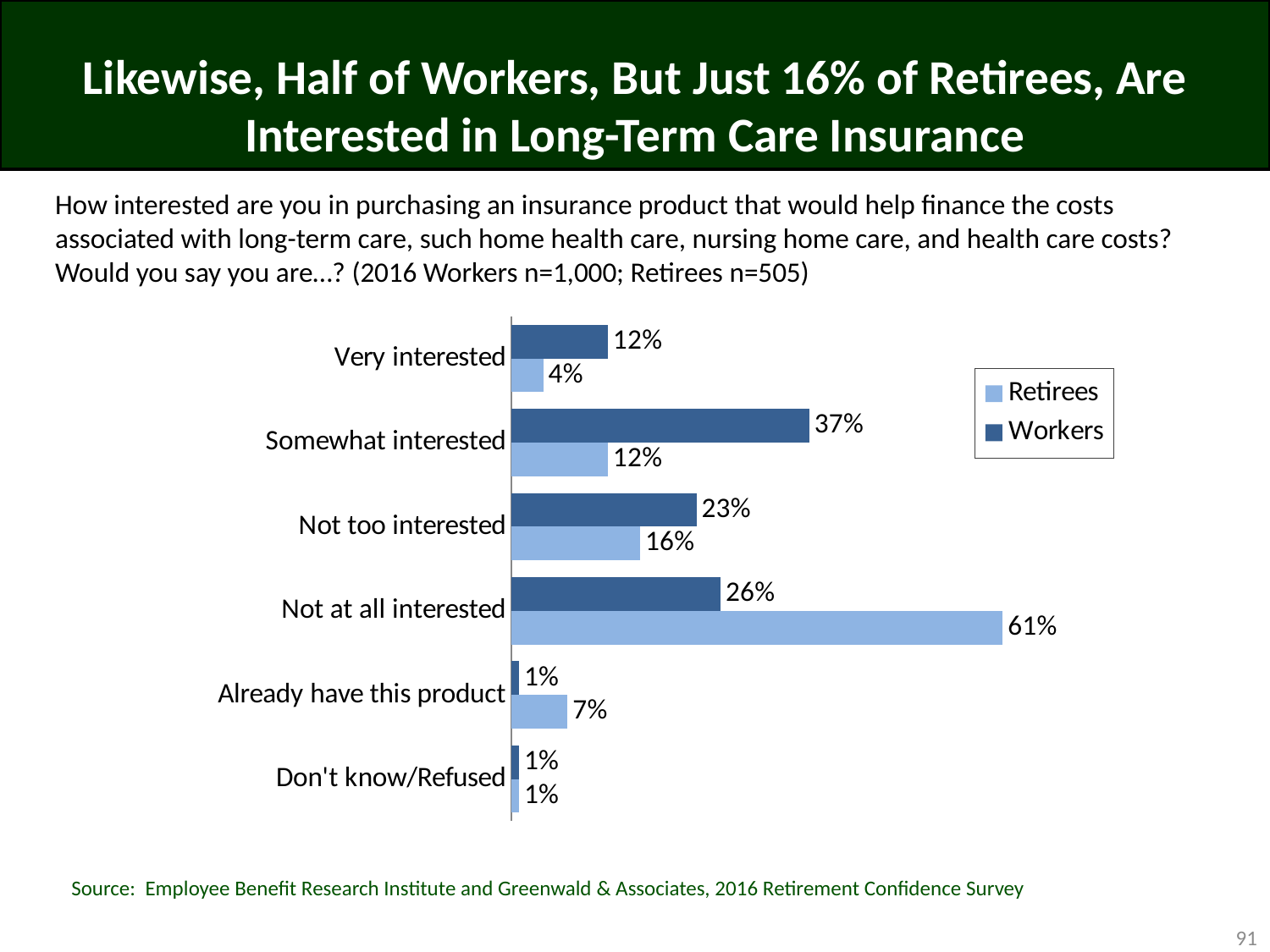
What percentage of Retirees are Very interested? 4% How many series does the legend list? 2 What is the difference between Workers and Retirees for Somewhat interested? 25% What percentage of Retirees are Not at all interested? 61% How many categories are shown on the chart? 6 What kind of chart is shown on the slide? Bar chart What percentage of Retirees Already have this product? 7% Which category has the highest value for Workers? Somewhat interested Which is larger for Not too interested, Workers or Retirees? Workers What is the difference between Retirees and Workers for Not at all interested? 35% What percentage of Workers are Somewhat interested? 37% Which category has the highest value for Retirees? Not at all interested